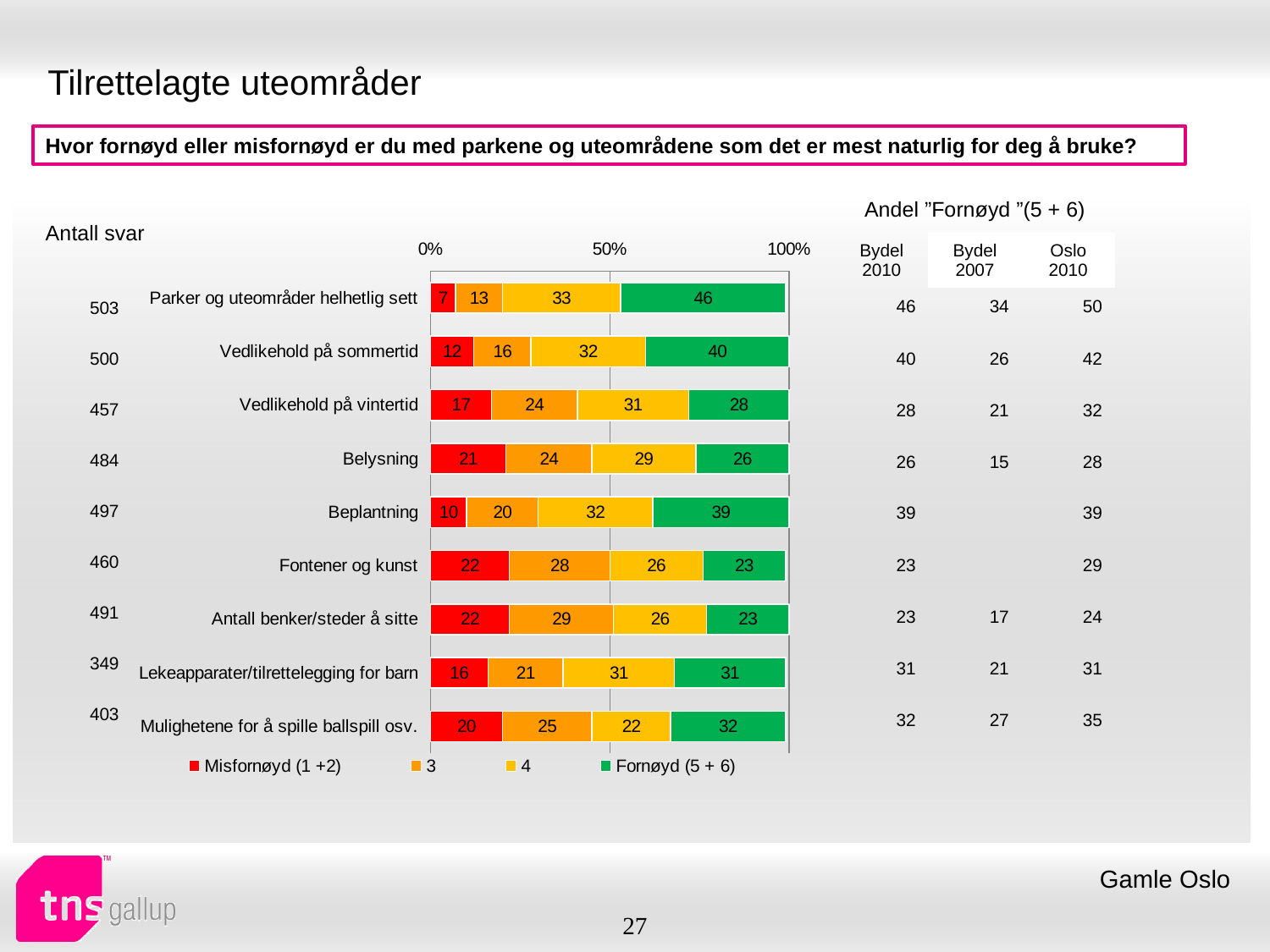
What is the value of the Misfornøyd (1 +2) segment for "Belysning"? 21 What is the first entry in the chart legend? Misfornøyd (1 +2) What is the value of the Fornøyd (5 + 6) segment for "Parker og uteområder helhetlig sett"? 46 How many series does the legend list? 4 For "Vedlikehold på sommertid", what is the difference between the Fornøyd (5 + 6) value and the Misfornøyd (1 +2) value? 28 Which has a larger Fornøyd (5 + 6) value: "Beplantning" or "Vedlikehold på vintertid"? Beplantning What is the total of the stacked bar for "Belysning"? 100 Which category has the highest Fornøyd (5 + 6) value? Parker og uteområder helhetlig sett What kind of chart is shown on the slide? Stacked bar chart Which category has the lowest Misfornøyd (1 +2) value? Parker og uteområder helhetlig sett How many categories are shown in the chart? 9 What is the value of the "4" segment for "Mulighetene for å spille ballspill osv."? 22